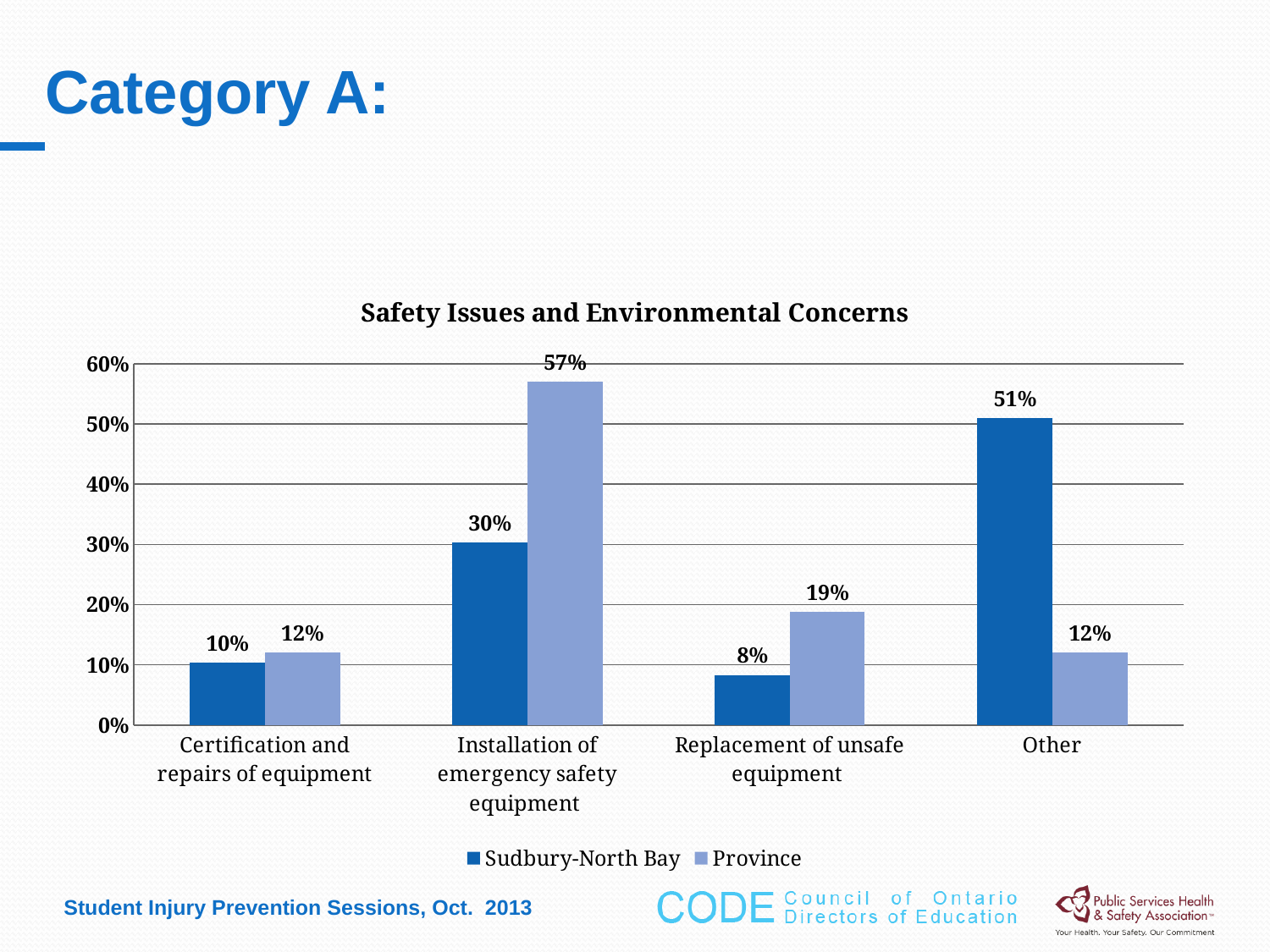
What is the title of the chart? Safety Issues and Environmental Concerns For Other, which series has the larger value, Sudbury-North Bay or Province? Sudbury-North Bay Is the Province value for Certification and repairs of equipment greater or less than 20%? less How many series does the legend list? 2 How many categories are shown on the x axis? 4 What is the Province value for Replacement of unsafe equipment? 19% What is the Sudbury-North Bay value for Other? 51% What kind of chart is shown? bar chart What is the Sudbury-North Bay value for Installation of emergency safety equipment? 30% Which category has the lowest Sudbury-North Bay value? Replacement of unsafe equipment Which category has the highest Province value? Installation of emergency safety equipment What is the difference between the Province and Sudbury-North Bay values for Installation of emergency safety equipment? 27%